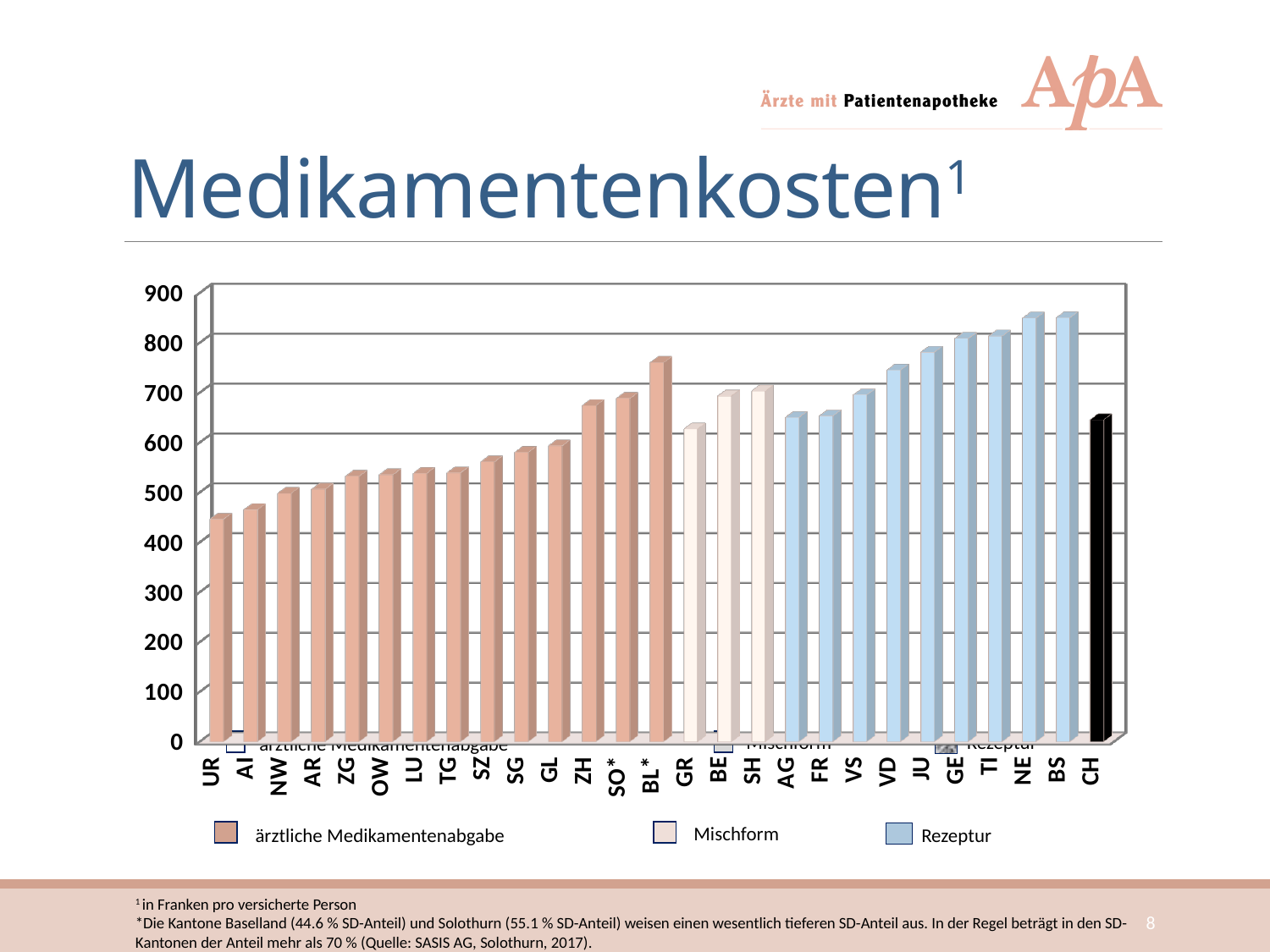
Is the value for BL* greater or less than 700? greater What kind of chart is shown on the slide? bar chart Which is larger, the value for UR or the value for BL*? BL* How many series does the legend list? 3 Which category has the lowest value? UR How many bars (categories) are shown on the x axis? 27 Is the value for NE greater or less than 800? greater What are the three legend entries of the chart? ärztliche Medikamentenabgabe, Mischform, Rezeptur Is the value for CH greater or less than 600? greater Which is larger, the value for AI or the value for VD? VD Do the values generally rise or fall from left to right along the x axis? rise